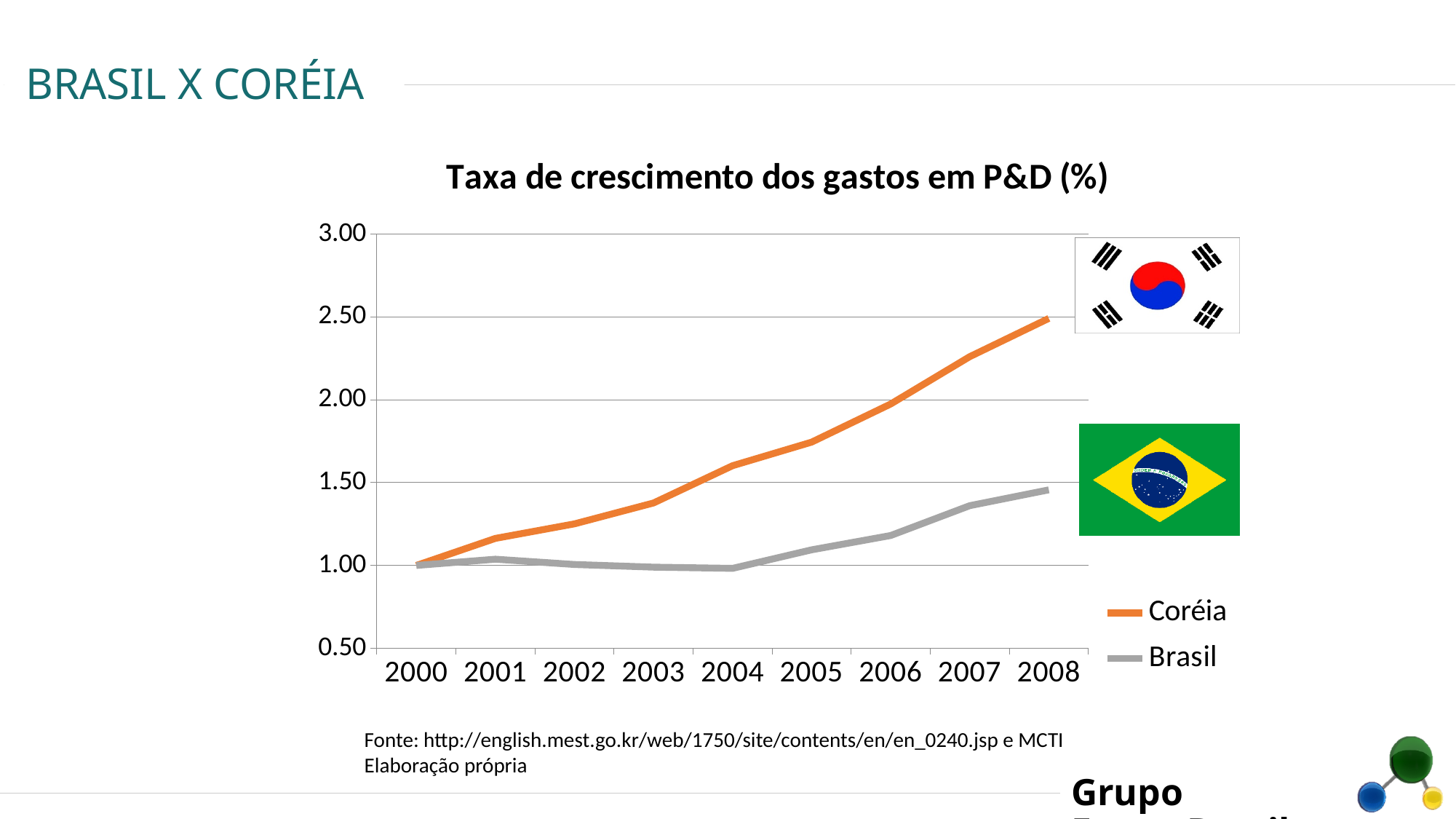
What kind of chart is shown on the slide? line chart Does the Coréia series rise or fall from 2000 to 2008? rise How many series does the legend list? 2 In 2008, which series has the larger value, Coréia or Brasil? Coréia Is the value for Brasil in 2007 greater or less than 1.50? less Is the value for Coréia in 2008 greater or less than 2.00? greater Is the value for Brasil in 2004 greater or less than 1.50? less What is the title of the chart? Taxa de crescimento dos gastos em P&D (%) How many years are shown on the x axis? 9 In which year does the Coréia series reach its highest value? 2008 Which series is drawn in orange? Coréia